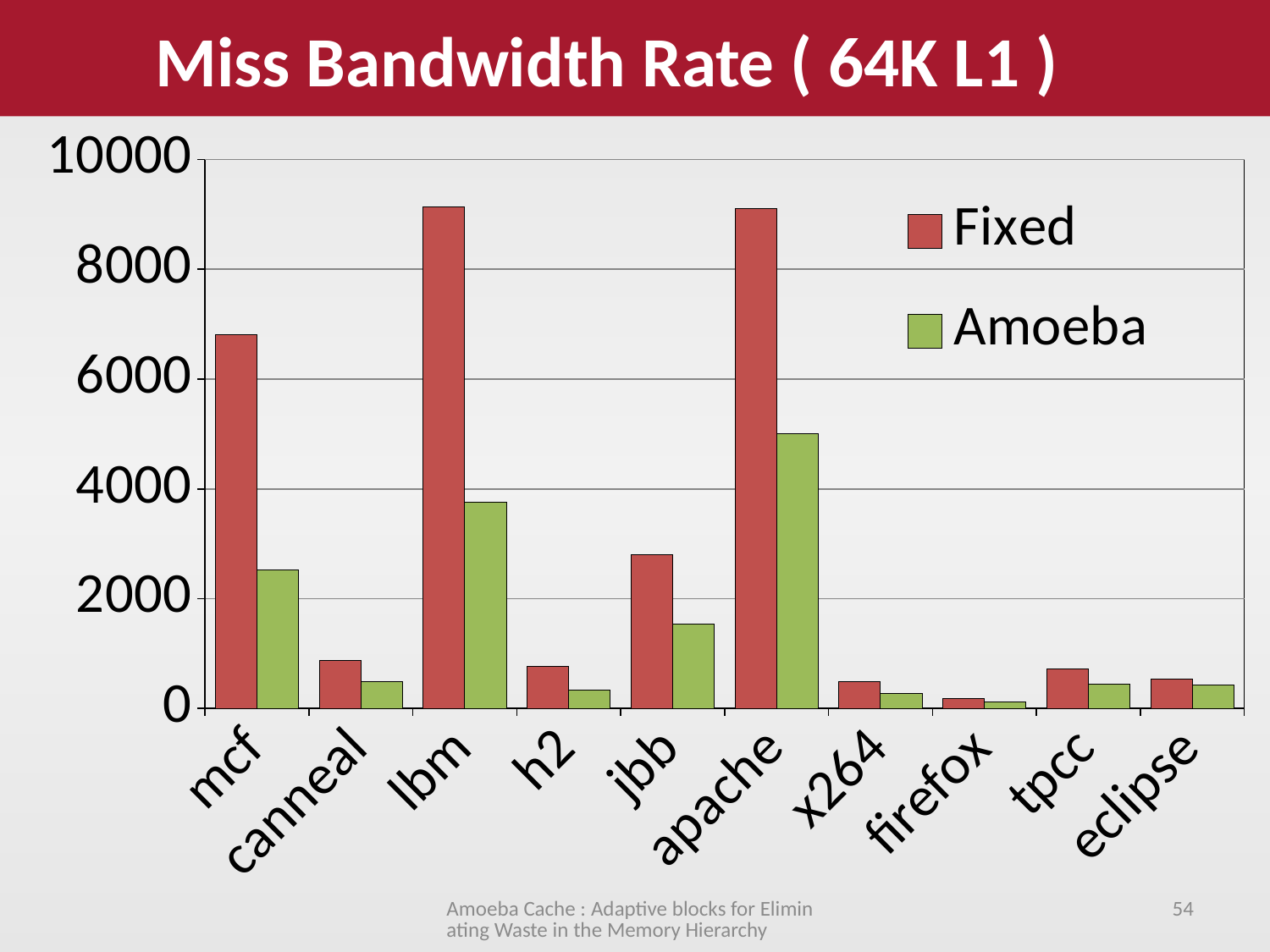
For mcf, which is larger: the Fixed value or the Amoeba value? Fixed Which is larger: the Amoeba value for apache or the Amoeba value for lbm? apache Which category has the lowest Fixed value? firefox How many series does the legend list? 2 Is the Fixed value for lbm greater or less than 8000? greater Which category has the highest Amoeba value? apache How many benchmark categories are shown on the x axis? 10 Is the Amoeba value for lbm greater or less than 4000? less What kind of chart is shown on the slide? bar chart What is the title of the chart? Miss Bandwidth Rate ( 64K L1 ) Is the Fixed value for jbb greater or less than 2000? greater